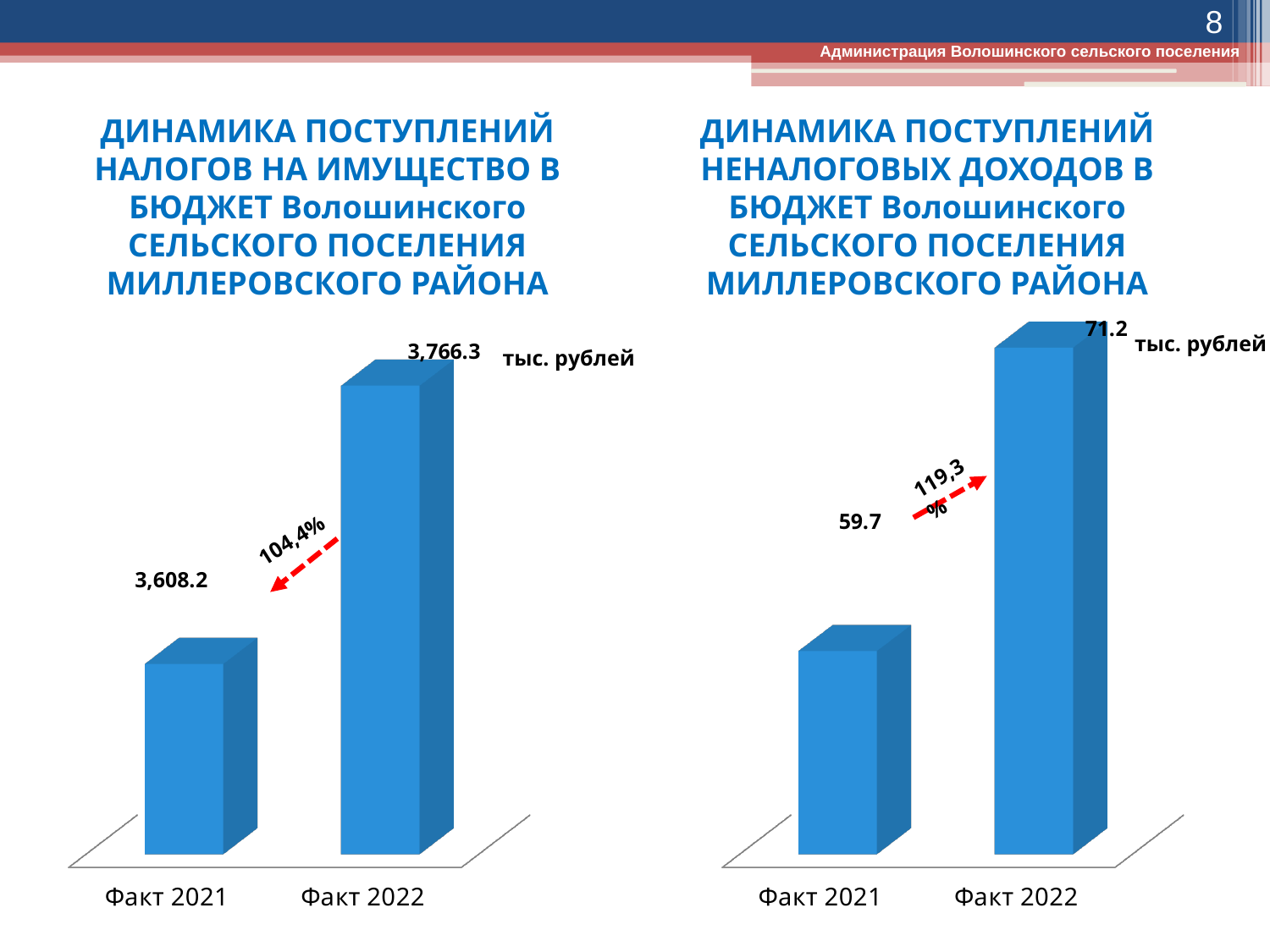
How many categories are shown in the left chart (property taxes)? 2 In the left chart (property taxes), what growth percentage is shown next to the arrow between the bars? 104,4% In the right chart (non-tax revenues), what is the value for Факт 2021? 59.7 In the right chart (non-tax revenues), what is the difference between the Факт 2022 and Факт 2021 values? 11.5 What type of chart is the right chart (non-tax revenues)? bar chart In the left chart (property taxes), what is the value for Факт 2021? 3,608.2 In the left chart (property taxes), what is the value for Факт 2022? 3,766.3 In the left chart (property taxes), which category has the higher value? Факт 2022 In the left chart (property taxes), what is the difference between the Факт 2022 and Факт 2021 values? 158.1 In the right chart (non-tax revenues), which category has the lower value? Факт 2021 In the right chart (non-tax revenues), is the value for Факт 2022 larger or smaller than the value for Факт 2021? larger In the right chart (non-tax revenues), what is the value for Факт 2022? 71.2